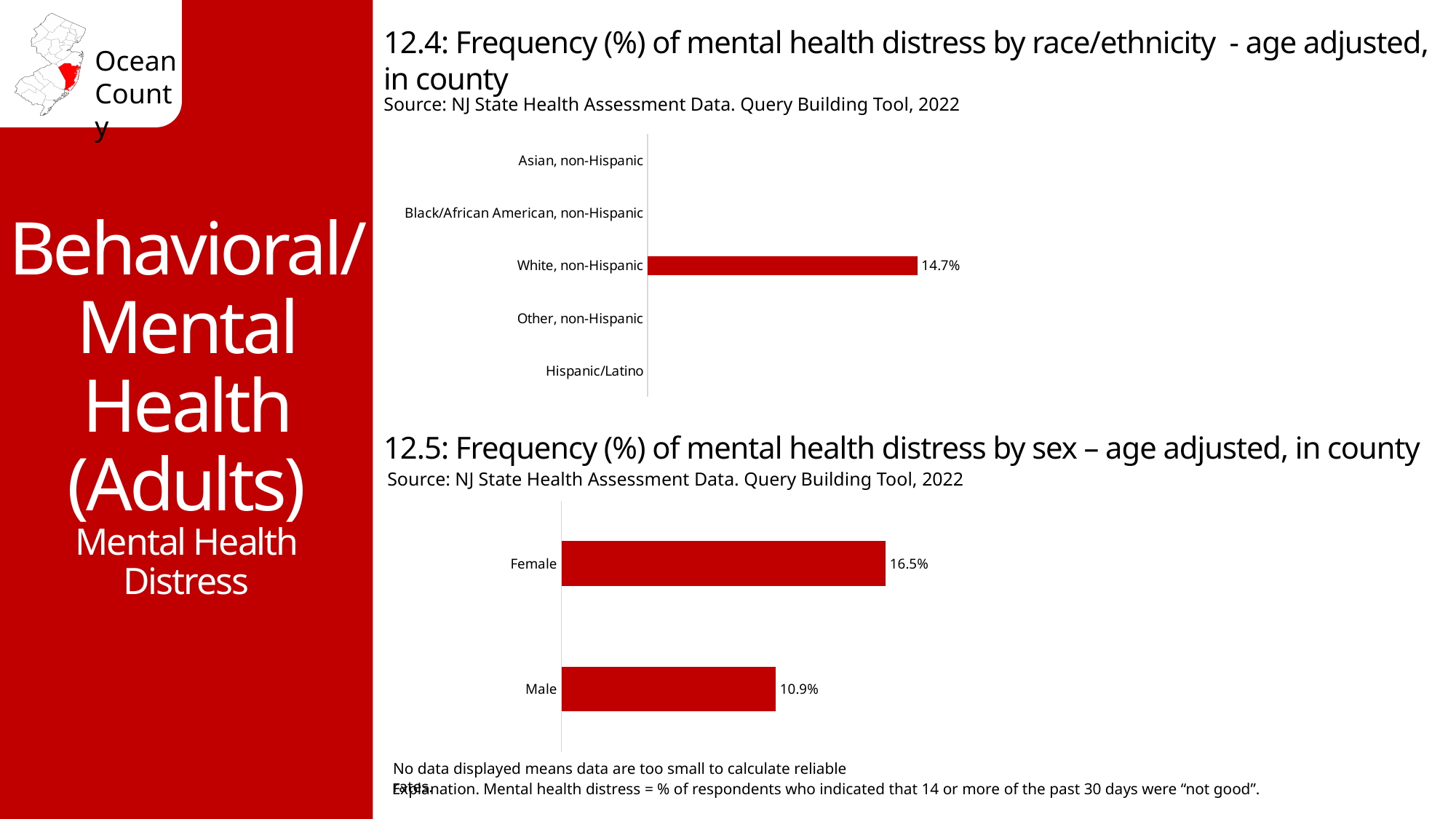
In the chart '12.5: Frequency (%) of mental health distress by sex – age adjusted, in county', how many categories are shown? 2 In the chart '12.5: Frequency (%) of mental health distress by sex – age adjusted, in county', which category has the highest value? Female In the chart '12.4: Frequency (%) of mental health distress by race/ethnicity - age adjusted, in county', what is the value for White, non-Hispanic? 14.7% What kind of chart is '12.4: Frequency (%) of mental health distress by race/ethnicity - age adjusted, in county'? Bar chart What kind of chart is '12.5: Frequency (%) of mental health distress by sex – age adjusted, in county'? Bar chart In the chart '12.5: Frequency (%) of mental health distress by sex – age adjusted, in county', what is the value for Male? 10.9% In the chart '12.4: Frequency (%) of mental health distress by race/ethnicity - age adjusted, in county', how many race/ethnicity categories are listed on the axis? 5 In the chart '12.5: Frequency (%) of mental health distress by sex – age adjusted, in county', what is the difference between the Female and Male values? 5.6% In the chart '12.4: Frequency (%) of mental health distress by race/ethnicity - age adjusted, in county', which category is the only one with a bar displayed? White, non-Hispanic In the chart '12.5: Frequency (%) of mental health distress by sex – age adjusted, in county', which category has the lowest value? Male In the chart '12.5: Frequency (%) of mental health distress by sex – age adjusted, in county', what is the value for Female? 16.5% In the chart '12.5: Frequency (%) of mental health distress by sex – age adjusted, in county', is the value for Female larger or smaller than the value for Male? Larger